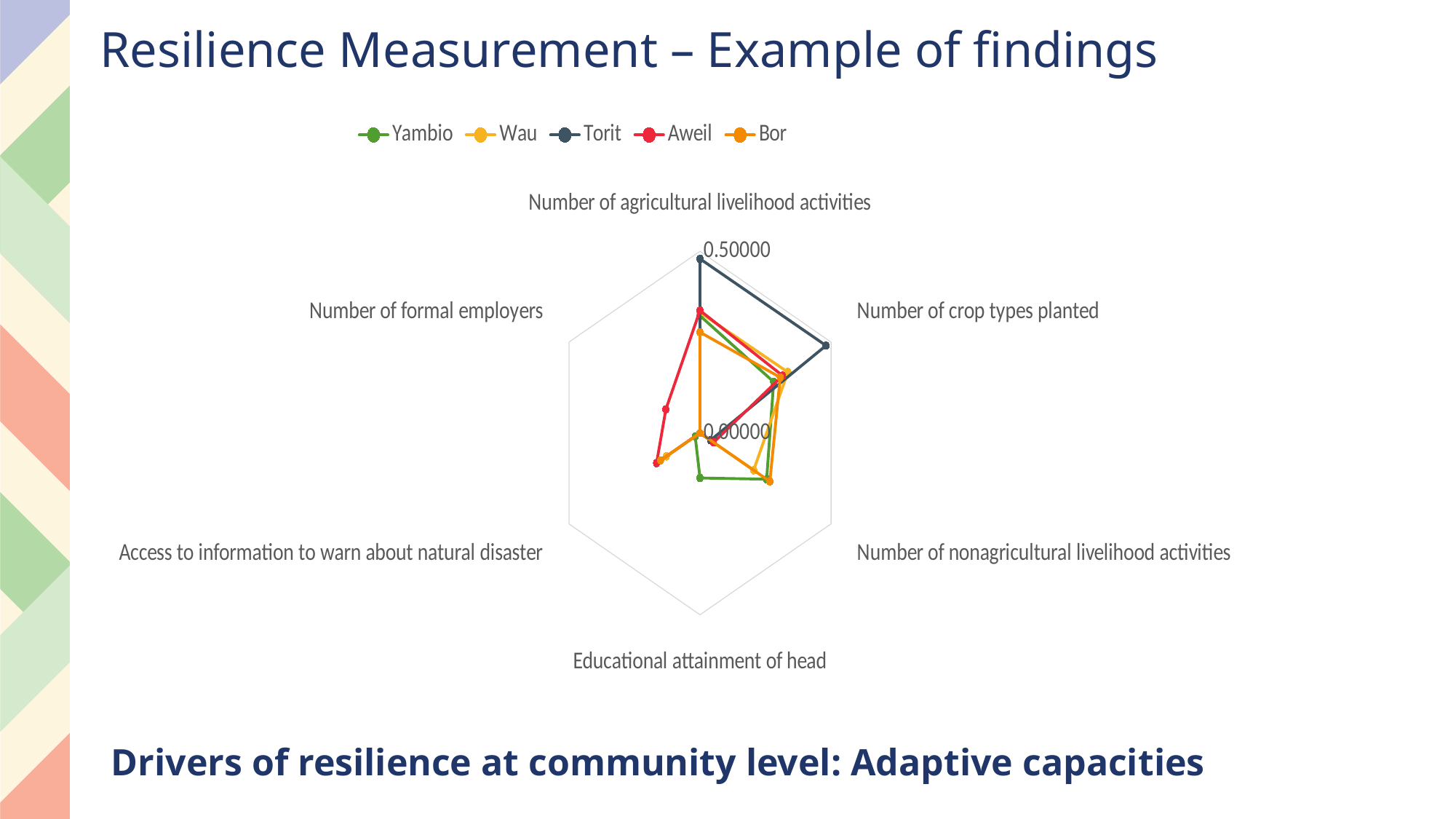
Which is larger for Number of formal employers: Aweil or Yambio? Aweil How many axes (categories) does the radar chart have? 6 Which is larger for Number of agricultural livelihood activities: Torit or Aweil? Torit Is Aweil's value for Number of formal employers greater or less than 0.50000? less What kind of chart is shown on the slide? Radar chart How many series does the legend list? 5 Which series has the highest value for Number of crop types planted? Torit Which series has the highest value for Number of agricultural livelihood activities? Torit Which series has the highest value for Access to information to warn about natural disaster? Aweil What are the five series listed in the legend? Yambio, Wau, Torit, Aweil, Bor